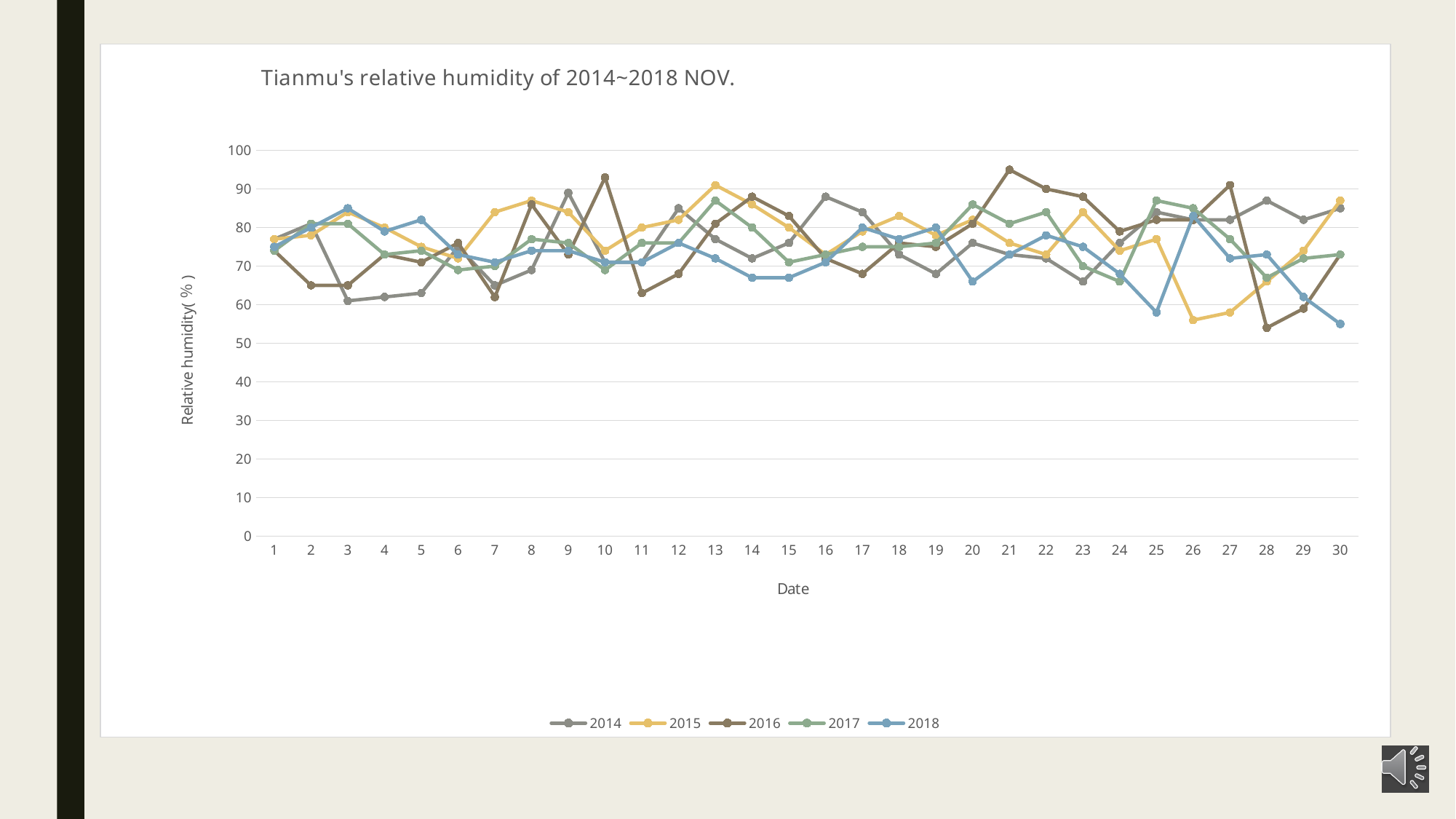
Is the value for 2015 on date 26 greater or less than 60? less How many dates are plotted along the x axis? 30 What is the title of the chart? Tianmu's relative humidity of 2014~2018 NOV. What is the label of the y axis? Relative humidity( % ) What kind of chart is shown on the slide? line chart Is the value for 2016 on date 21 greater or less than 90? greater On date 21, which series has the larger value, 2016 or 2018? 2016 Is the value for 2016 on date 10 greater or less than 90? greater How many series does the legend list? 5 On date 28, which series has the larger value, 2014 or 2016? 2014